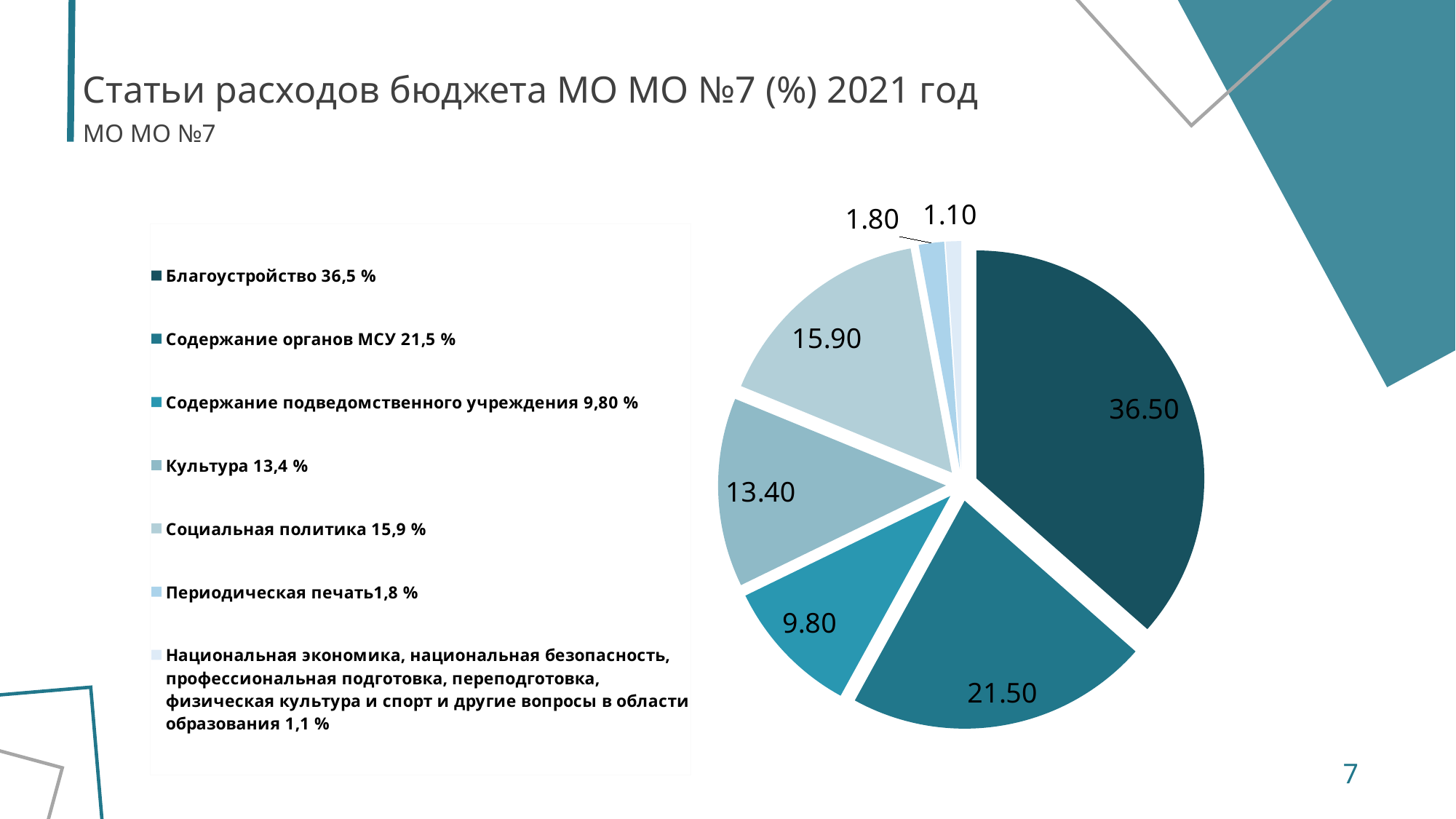
What is the difference between the Благоустройство value and the Содержание органов МСУ value? 15.00 What is the value shown for the Содержание органов МСУ slice? 21.50 What is the value shown for the Социальная политика slice? 15.90 Which is larger: the Социальная политика slice or the Культура slice? Социальная политика Which category has the smallest slice of the pie? Национальная экономика, национальная безопасность, профессиональная подготовка, переподготовка, физическая культура и спорт и другие вопросы в области образования Which category has the largest slice of the pie? Благоустройство What is the value shown for the Благоустройство slice? 36.50 What is the difference between the Периодическая печать value and the Национальная экономика value? 0.70 What kind of chart is shown on the slide? pie chart What is the value shown for the Культура slice? 13.40 What is the title of the slide containing the chart? Статьи расходов бюджета МО МО №7 (%) 2021 год How many slices does the pie chart have? 7